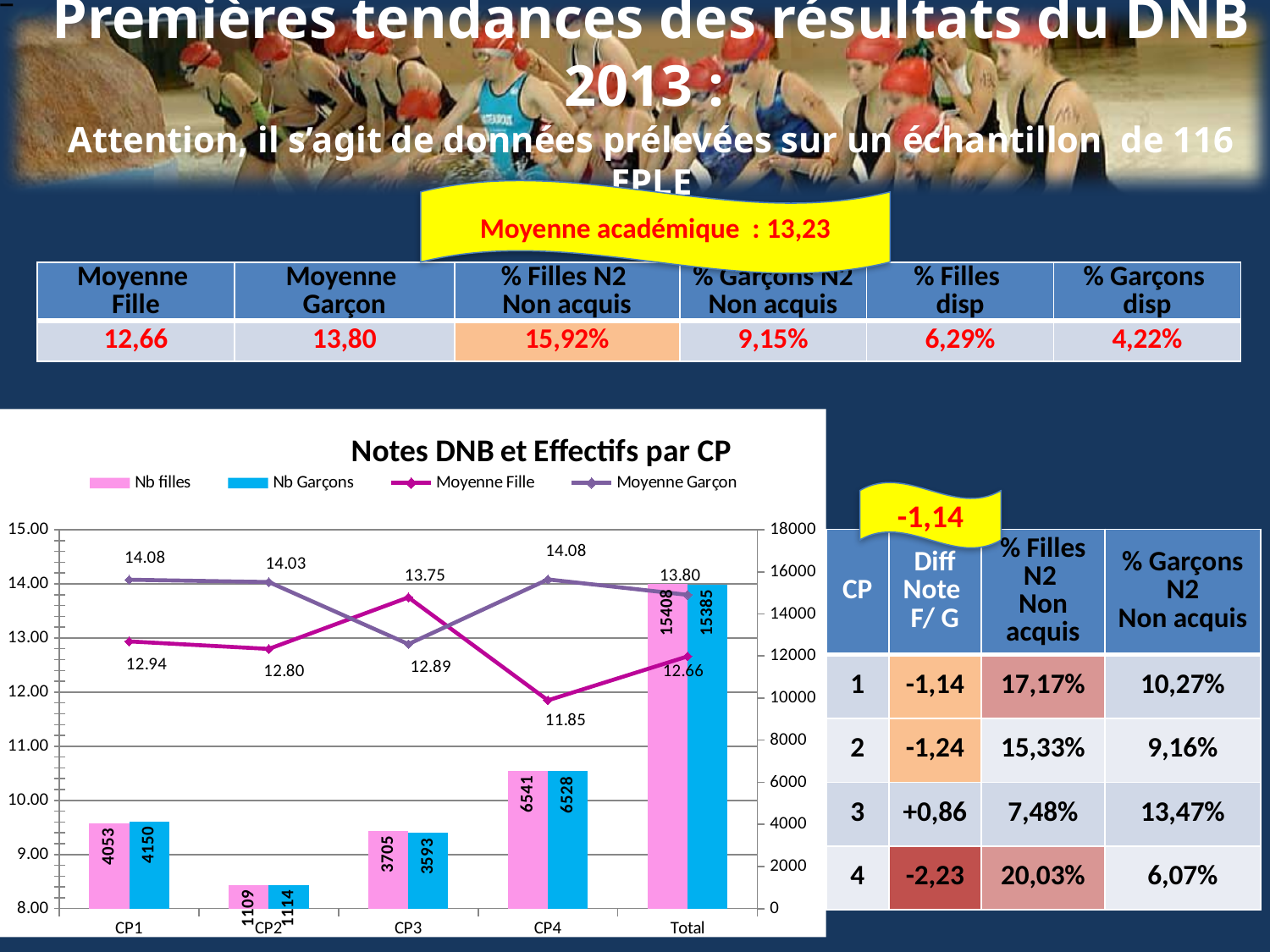
In the chart 'Notes DNB et Effectifs par CP', what is the Moyenne Garçon value for CP2? 14.03 What is the title of the chart on the slide? Notes DNB et Effectifs par CP How many categories are shown on the x axis of the chart 'Notes DNB et Effectifs par CP'? 5 In the chart 'Notes DNB et Effectifs par CP', what is the Nb Garçons value for Total? 15385 How many series does the legend of the chart 'Notes DNB et Effectifs par CP' list? 4 In the chart 'Notes DNB et Effectifs par CP', what is the value of Nb filles for CP4? 6541 In the chart 'Notes DNB et Effectifs par CP', what is the difference between Nb filles and Nb Garçons for CP3? 112 In the chart 'Notes DNB et Effectifs par CP', what is the difference between Moyenne Garçon and Moyenne Fille for CP1? 1.14 In the chart 'Notes DNB et Effectifs par CP', which is larger for CP3: Moyenne Fille or Moyenne Garçon? Moyenne Fille In the chart 'Notes DNB et Effectifs par CP', which category has the lowest Moyenne Fille value? CP4 In the chart 'Notes DNB et Effectifs par CP', which category has the lowest Nb filles value? CP2 In the chart 'Notes DNB et Effectifs par CP', what is the Moyenne Fille value for CP3? 13.75